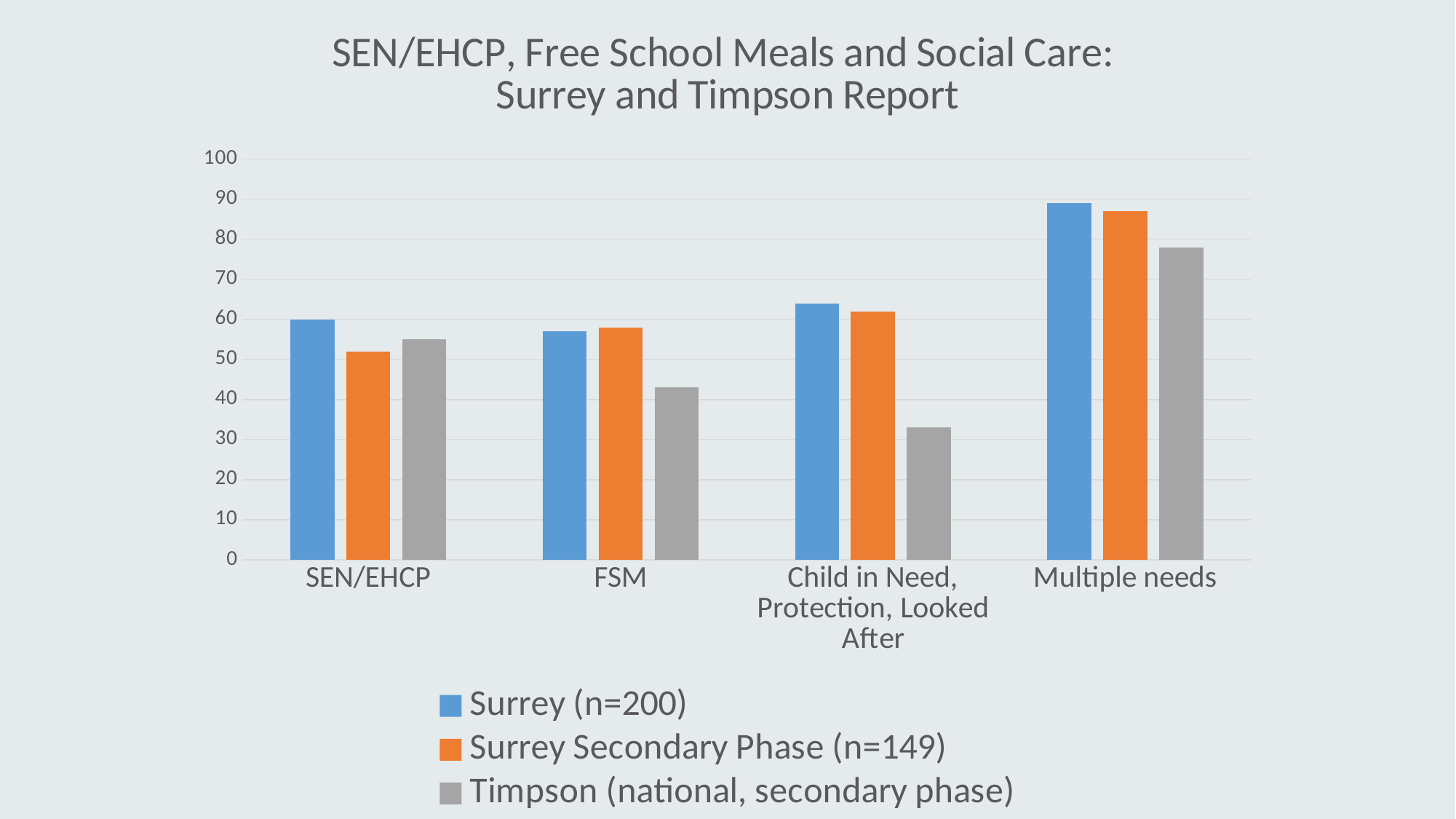
For FSM, which is larger: Surrey Secondary Phase (n=149) or Timpson (national, secondary phase)? Surrey Secondary Phase (n=149) Is the Timpson (national, secondary phase) value for FSM greater or less than 50? less How many series does the legend list? 3 Is the Timpson (national, secondary phase) value for Child in Need, Protection, Looked After greater or less than 40? less How many categories are shown on the x axis? 4 What is the title of the chart? SEN/EHCP, Free School Meals and Social Care: Surrey and Timpson Report Is the Surrey (n=200) value for Multiple needs greater or less than 80? greater For the Surrey (n=200) series, which category has the highest value? Multiple needs What kind of chart is shown on the slide? bar chart Which series is shown in orange? Surrey Secondary Phase (n=149) For Child in Need, Protection, Looked After, which is larger: Surrey (n=200) or Timpson (national, secondary phase)? Surrey (n=200) For the Timpson (national, secondary phase) series, which category has the lowest value? Child in Need, Protection, Looked After